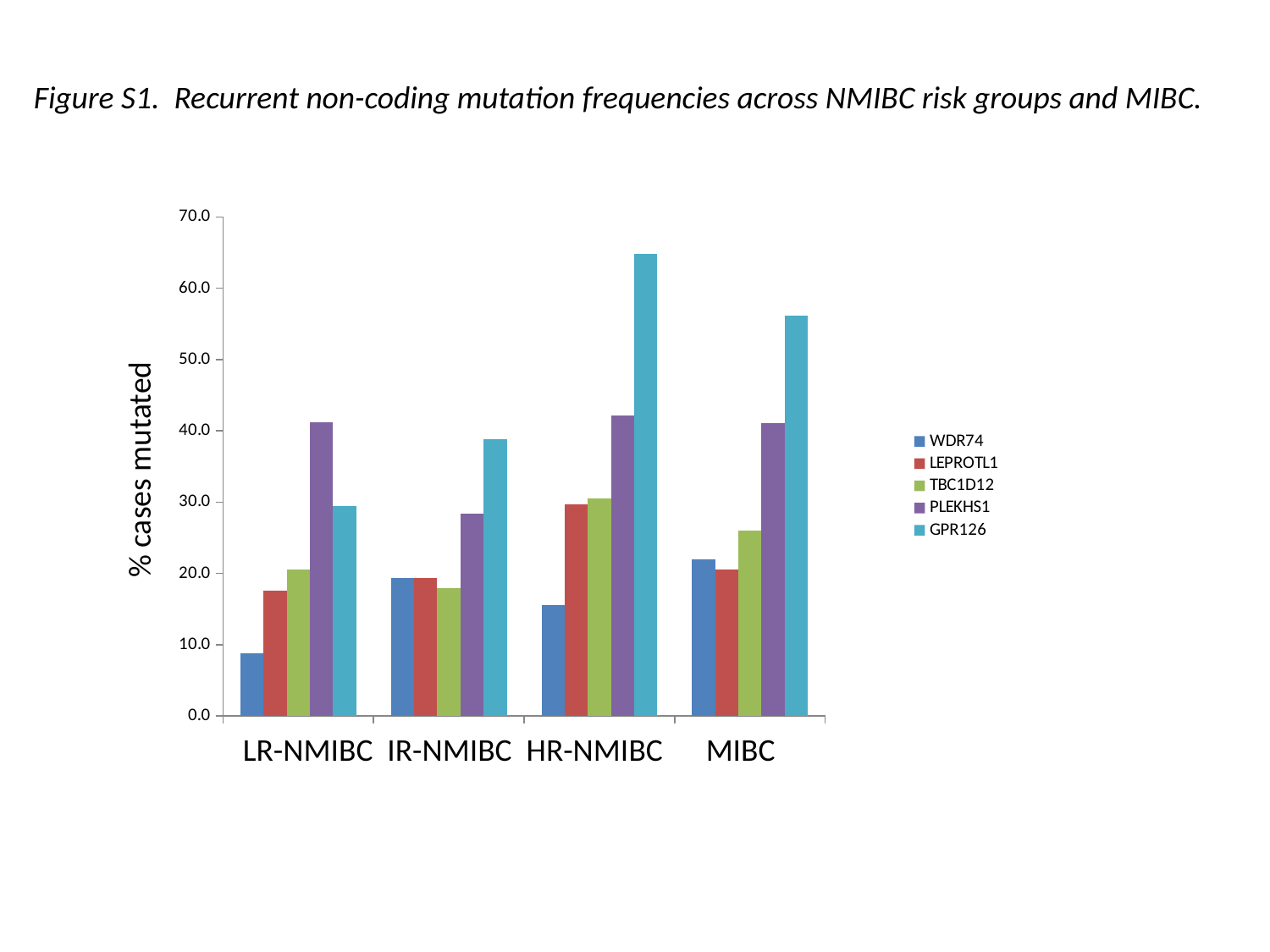
How many series does the legend list? 5 What kind of chart is shown on the slide? Bar chart Is the value for GPR126 in HR-NMIBC greater or less than 60.0? greater Is the value for WDR74 in LR-NMIBC greater or less than 10.0? less In MIBC, which is larger: GPR126 or PLEKHS1? GPR126 How many categories are shown along the x axis? 4 What is the label on the y axis? % cases mutated Which category has the highest value for GPR126? HR-NMIBC Which category has the lowest value for WDR74? LR-NMIBC Is the value for TBC1D12 in MIBC greater or less than 20.0? greater Within HR-NMIBC, which gene has the highest percentage of cases mutated? GPR126 In LR-NMIBC, which is larger: PLEKHS1 or GPR126? PLEKHS1